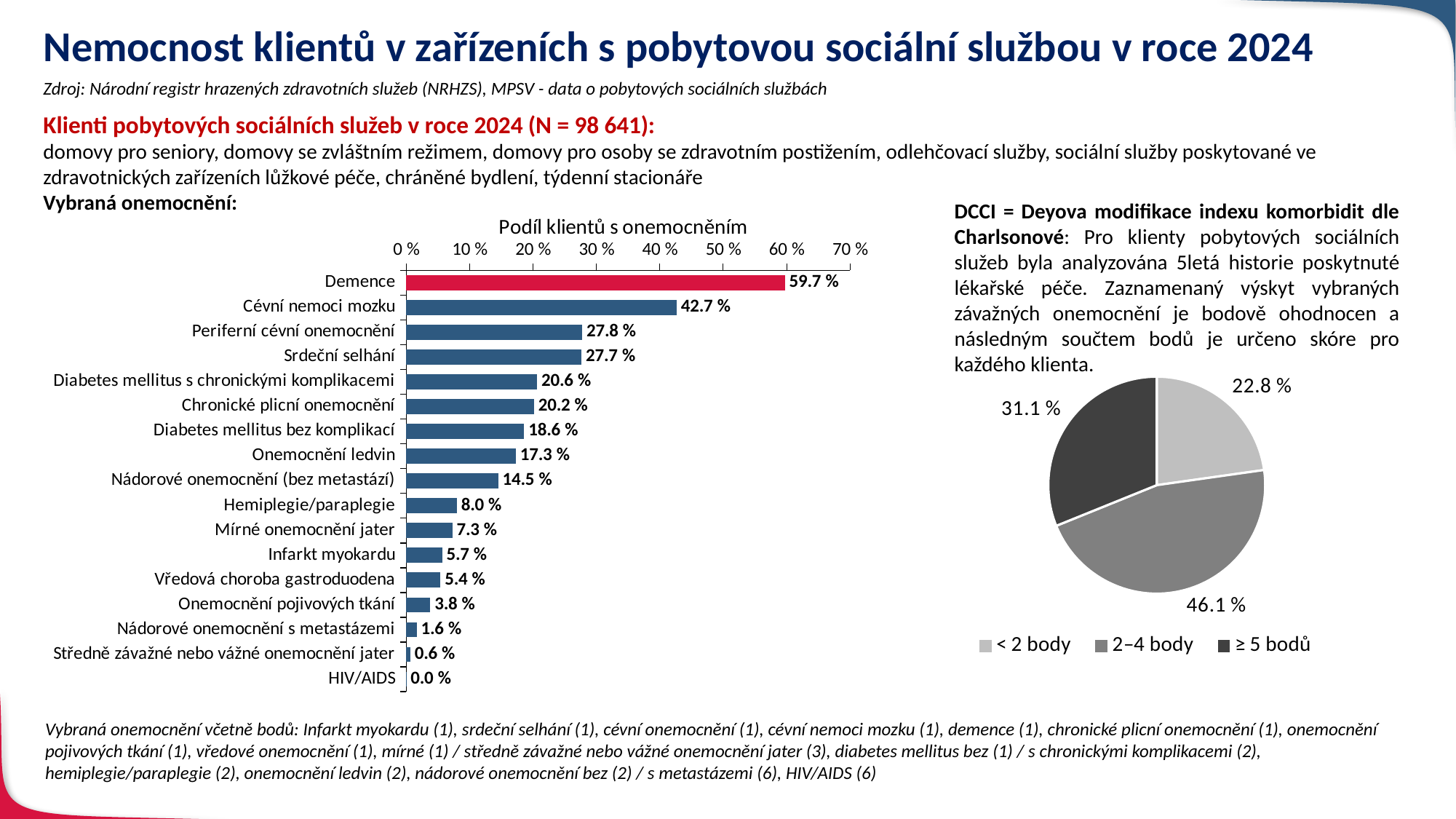
In the bar chart 'Podíl klientů s onemocněním', which category has the highest value? Demence How many categories are shown in the bar chart 'Podíl klientů s onemocněním'? 17 What kind of chart is the chart titled 'Podíl klientů s onemocněním'? Bar chart How many entries does the legend of the pie chart on the right list? 3 In the bar chart 'Podíl klientů s onemocněním', what is the difference between the values for Demence and Cévní nemoci mozku? 17.0 % In the pie chart on the right, which slice is the largest? 2–4 body In the bar chart 'Podíl klientů s onemocněním', which is larger: Hemiplegie/paraplegie or Mírné onemocnění jater? Hemiplegie/paraplegie In the pie chart on the right, what is the share of the '2–4 body' slice? 46.1 % In the bar chart 'Podíl klientů s onemocněním', what is the value for Demence? 59.7 % In the bar chart 'Podíl klientů s onemocněním', which category has the lowest value? HIV/AIDS In the pie chart on the right, what is the difference between the '2–4 body' and '< 2 body' slices? 23.3 % In the bar chart 'Podíl klientů s onemocněním', what is the value for Onemocnění ledvin? 17.3 %